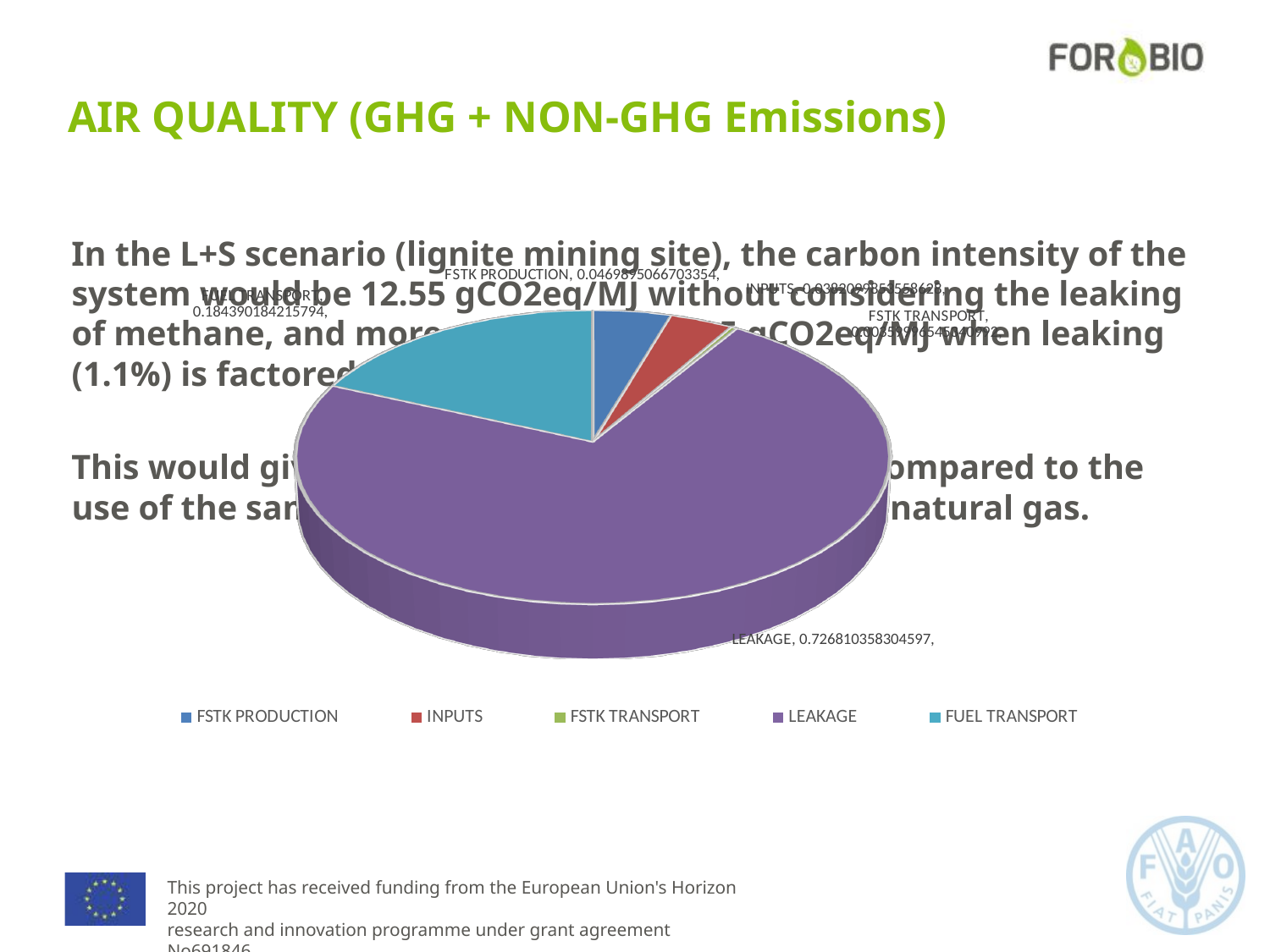
Which category has the smallest slice in the pie chart? FSTK TRANSPORT What colour is the LEAKAGE slice in the pie chart? Purple What is the value shown for FUEL TRANSPORT in the pie chart? 0.184390184215794 Which is larger in the pie chart, FUEL TRANSPORT or FSTK PRODUCTION? FUEL TRANSPORT What is the difference between the LEAKAGE value and the FUEL TRANSPORT value in the pie chart? 0.542420174088803 What is the value shown for FSTK PRODUCTION in the pie chart? 0.0469895066703354 What is the value shown for LEAKAGE in the pie chart? 0.726810358304597 Which is larger in the pie chart, LEAKAGE or FUEL TRANSPORT? LEAKAGE How many slices does the pie chart have? 5 Which category has the largest slice in the pie chart? LEAKAGE How many series does the legend of the pie chart list? 5 What kind of chart is shown on the slide? Pie chart